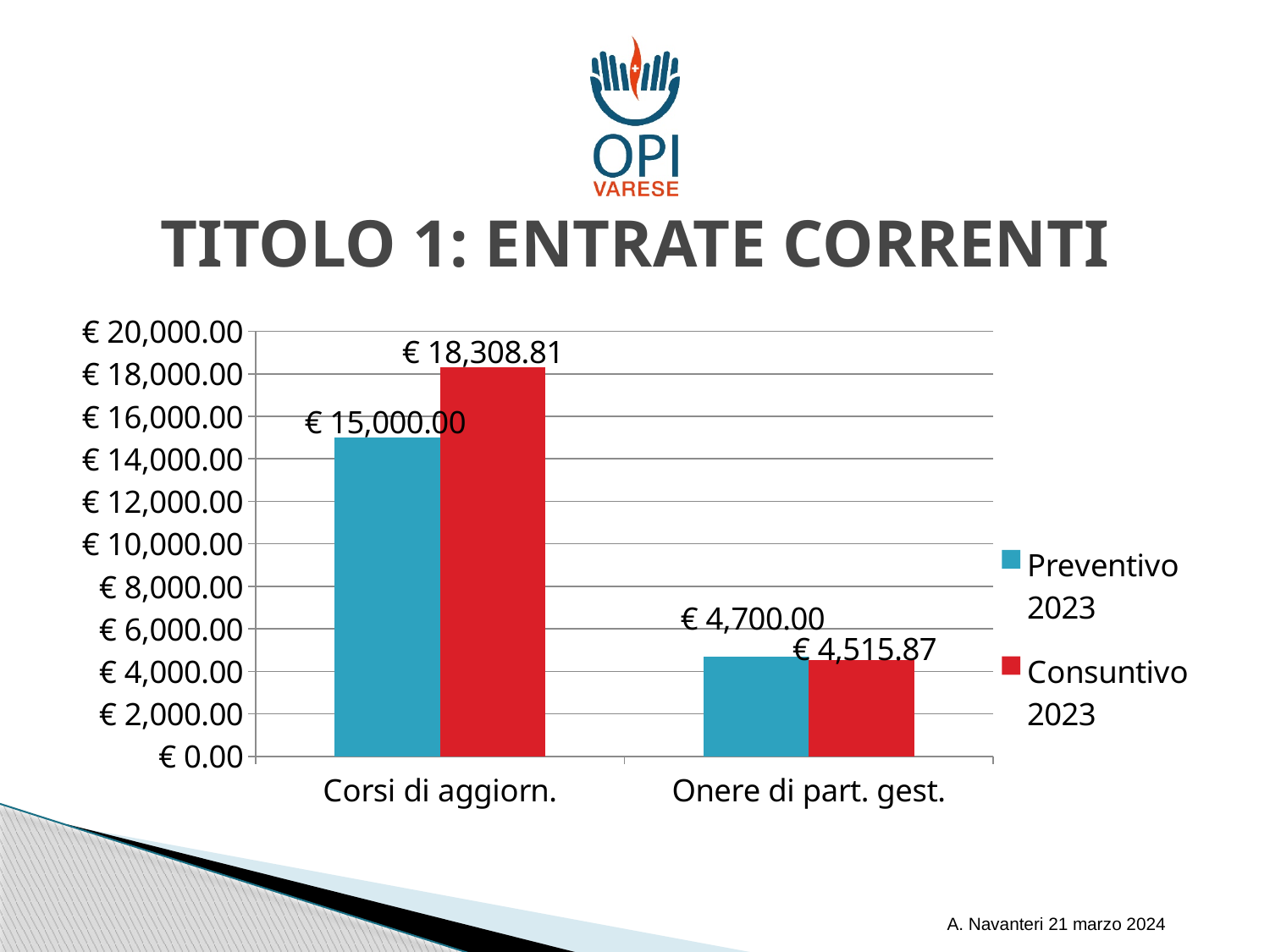
Which bar in the chart has the highest value? Consuntivo 2023 for Corsi di aggiorn. What is the difference between the Consuntivo 2023 and Preventivo 2023 values for Corsi di aggiorn.? € 3,308.81 For Corsi di aggiorn., which is larger: Preventivo 2023 or Consuntivo 2023? Consuntivo 2023 What is the Preventivo 2023 value for Corsi di aggiorn.? € 15,000.00 What is the difference between the Preventivo 2023 and Consuntivo 2023 values for Onere di part. gest.? € 184.13 What is the Consuntivo 2023 value for Onere di part. gest.? € 4,515.87 What is the Preventivo 2023 value for Onere di part. gest.? € 4,700.00 Which bar in the chart has the lowest value? Consuntivo 2023 for Onere di part. gest. How many categories are shown on the x axis of the chart? 2 What is the Consuntivo 2023 value for Corsi di aggiorn.? € 18,308.81 How many series does the chart legend list? 2 What type of chart is shown on the slide? Bar chart